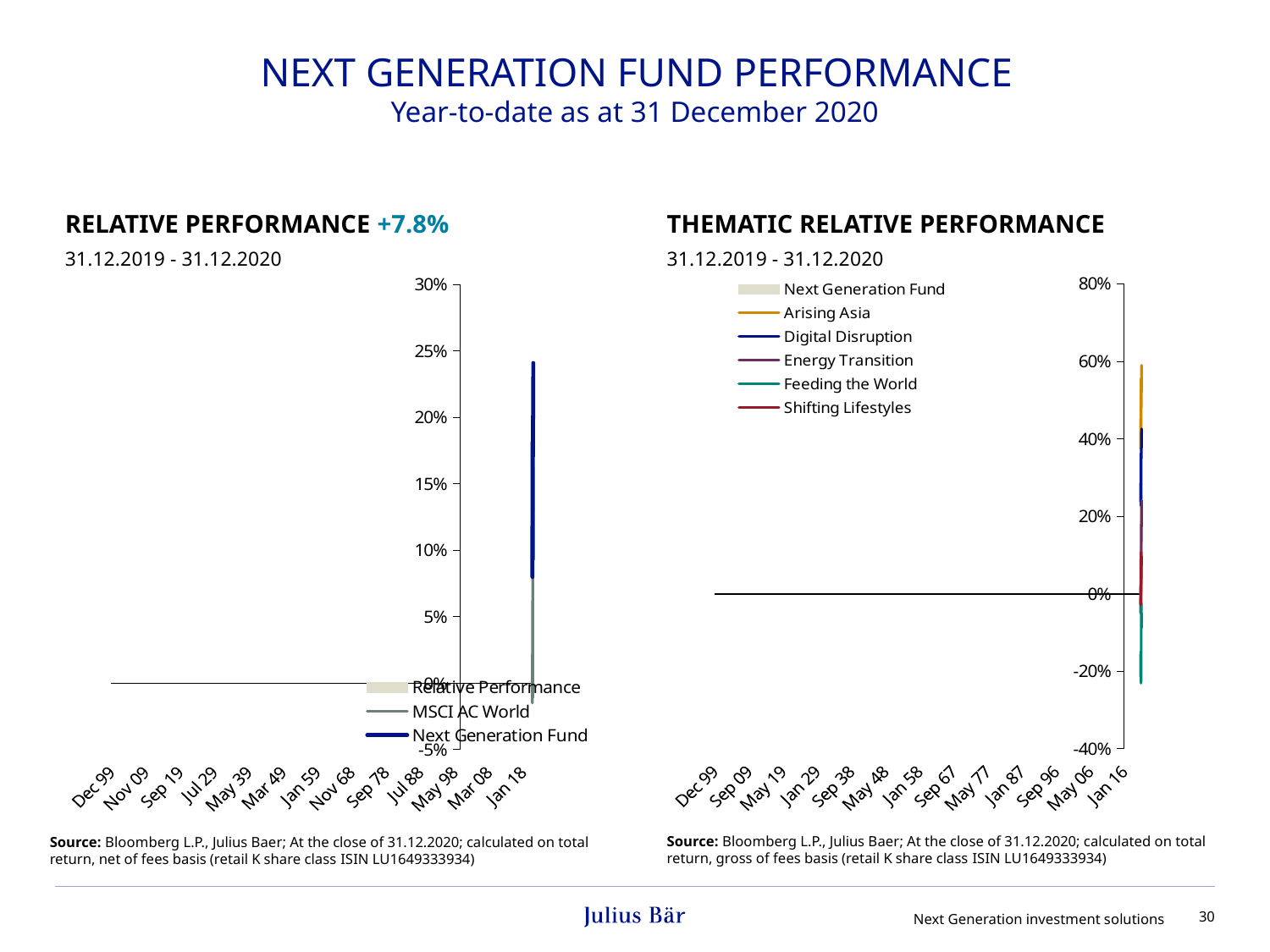
In the 'RELATIVE PERFORMANCE' chart on the left, which series is drawn in dark blue according to the legend? Next Generation Fund How many series does the legend of the 'THEMATIC RELATIVE PERFORMANCE' chart on the right list? 6 What kind of chart is the 'THEMATIC RELATIVE PERFORMANCE' chart on the right? line chart What kind of chart is the 'RELATIVE PERFORMANCE' chart on the left? line chart In the 'RELATIVE PERFORMANCE' chart on the left, what relative performance figure is shown in the chart heading? +7.8% What is the highest value shown on the y axis of the 'THEMATIC RELATIVE PERFORMANCE' chart on the right? 80% In the 'THEMATIC RELATIVE PERFORMANCE' chart on the right, which series is drawn in orange according to the legend? Arising Asia What is the lowest value shown on the y axis of the 'RELATIVE PERFORMANCE' chart on the left? -5% How many series does the legend of the 'RELATIVE PERFORMANCE' chart on the left list? 3 What date range is shown under the title of the 'THEMATIC RELATIVE PERFORMANCE' chart on the right? 31.12.2019 - 31.12.2020